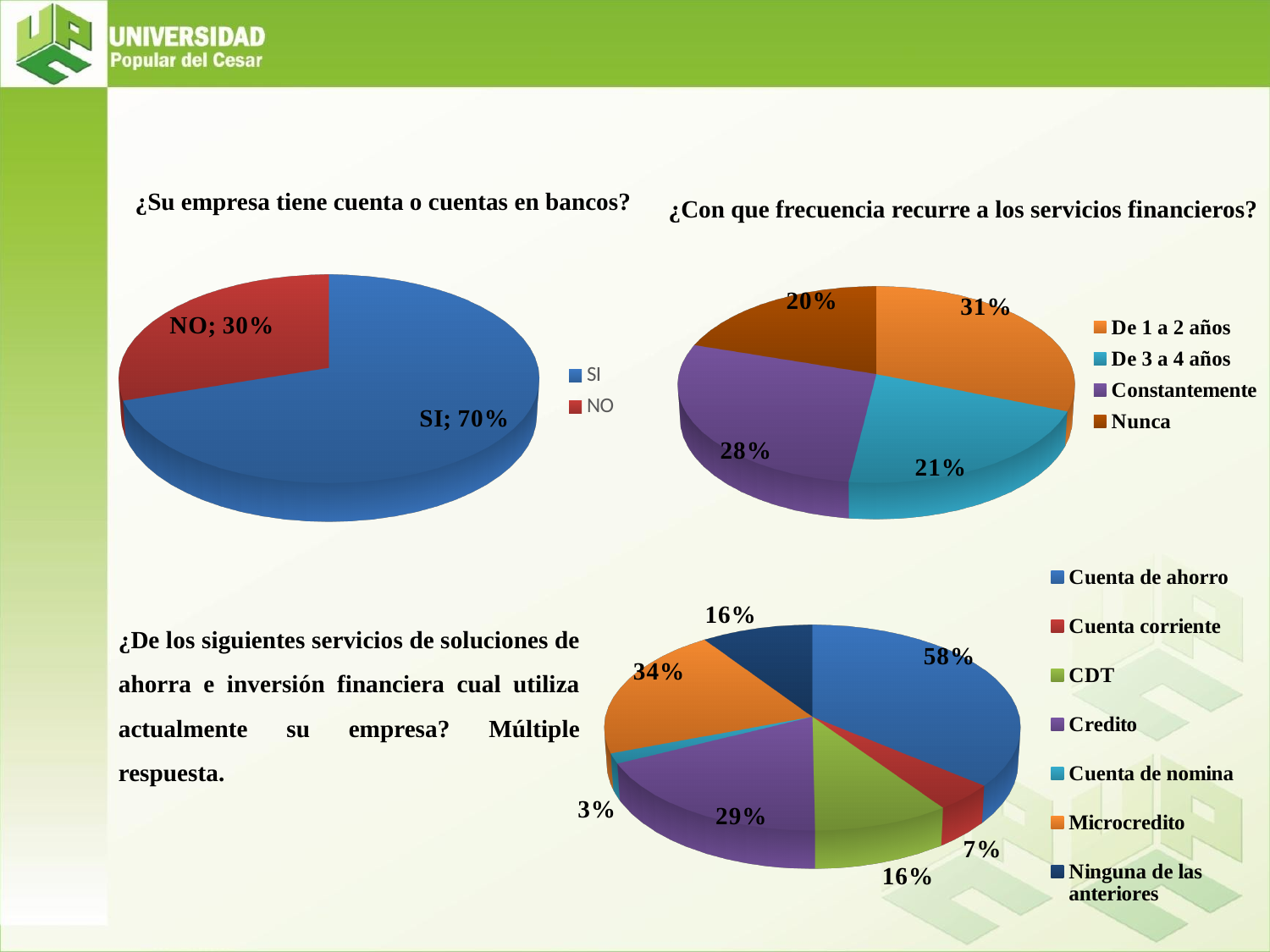
In the bottom chart about savings and investment services, which category has the smallest share? Cuenta de nomina How many categories does the legend list in the bottom chart about savings and investment services? 7 What kind of chart is used for '¿Con que frecuencia recurre a los servicios financieros?'? Pie chart In the chart titled '¿Su empresa tiene cuenta o cuentas en bancos?', what percentage is shown for SI? 70% In the bottom chart about savings and investment services, what percentage is shown for 'Cuenta de ahorro'? 58% In the chart titled '¿Con que frecuencia recurre a los servicios financieros?', which category has the largest share? De 1 a 2 años In the chart titled '¿Su empresa tiene cuenta o cuentas en bancos?', what percentage is shown for NO? 30% In the chart titled '¿Con que frecuencia recurre a los servicios financieros?', what percentage corresponds to 'Constantemente'? 28% In the chart titled '¿Su empresa tiene cuenta o cuentas en bancos?', what is the difference in percentage points between SI and NO? 40 In the bottom chart about savings and investment services, which is larger: Credito or Microcredito? Microcredito How many categories does the legend list in the chart titled '¿Con que frecuencia recurre a los servicios financieros?'? 4 In the chart titled '¿Con que frecuencia recurre a los servicios financieros?', which category has the smallest share? Nunca